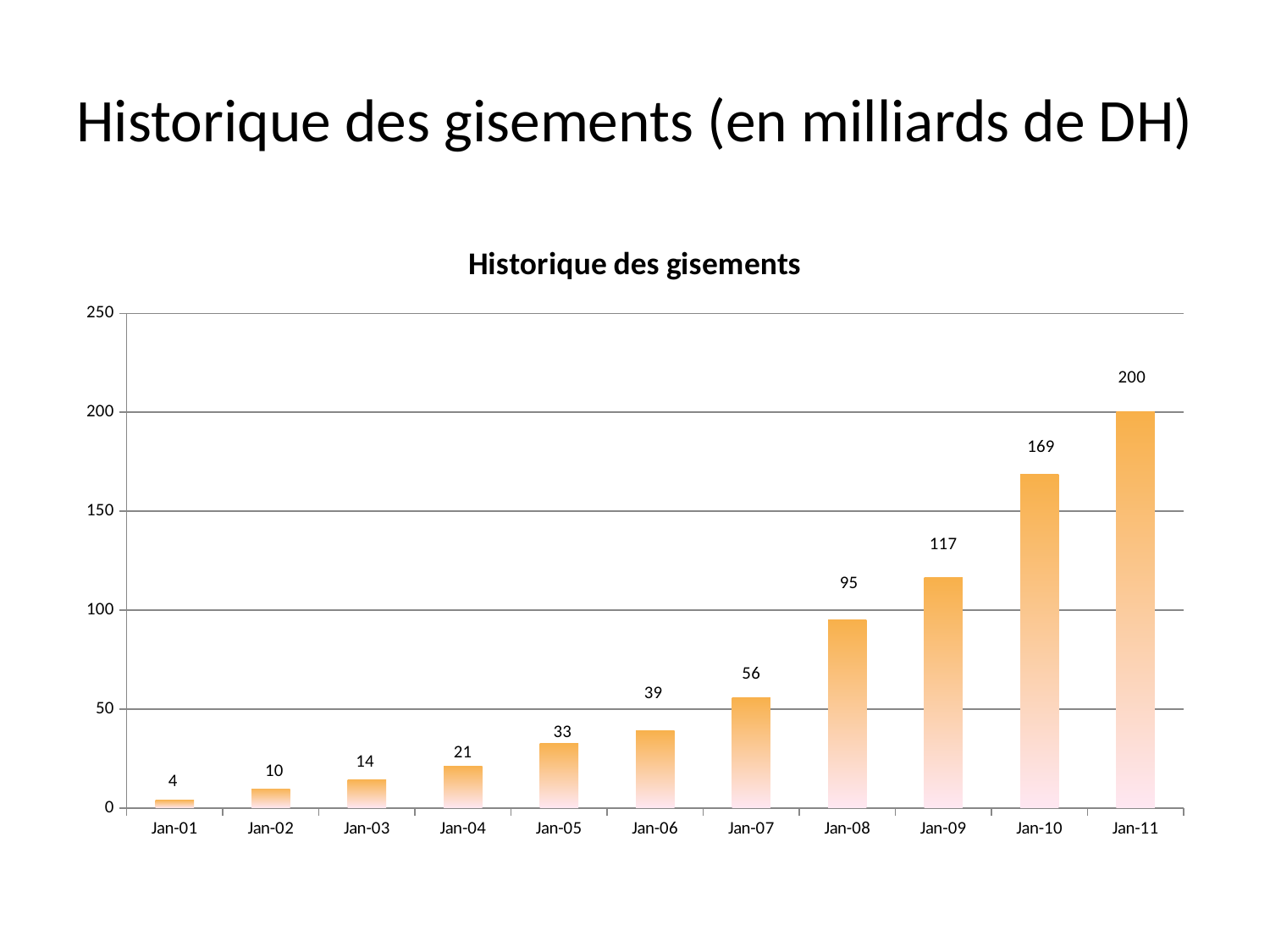
What is the title of the chart? Historique des gisements Is the value for Jan-09 greater or less than 100? greater What kind of chart is shown on the slide? bar chart Do the values rise or fall from Jan-01 to Jan-11? rise Which category has the lowest value? Jan-01 What is the difference between the values for Jan-10 and Jan-09? 52 What is the value for Jan-08? 95 What is the value for Jan-04? 21 Which is larger, the value for Jan-06 or the value for Jan-07? Jan-07 How many categories are shown on the x axis? 11 Which category has the highest value? Jan-11 What is the value for Jan-11? 200